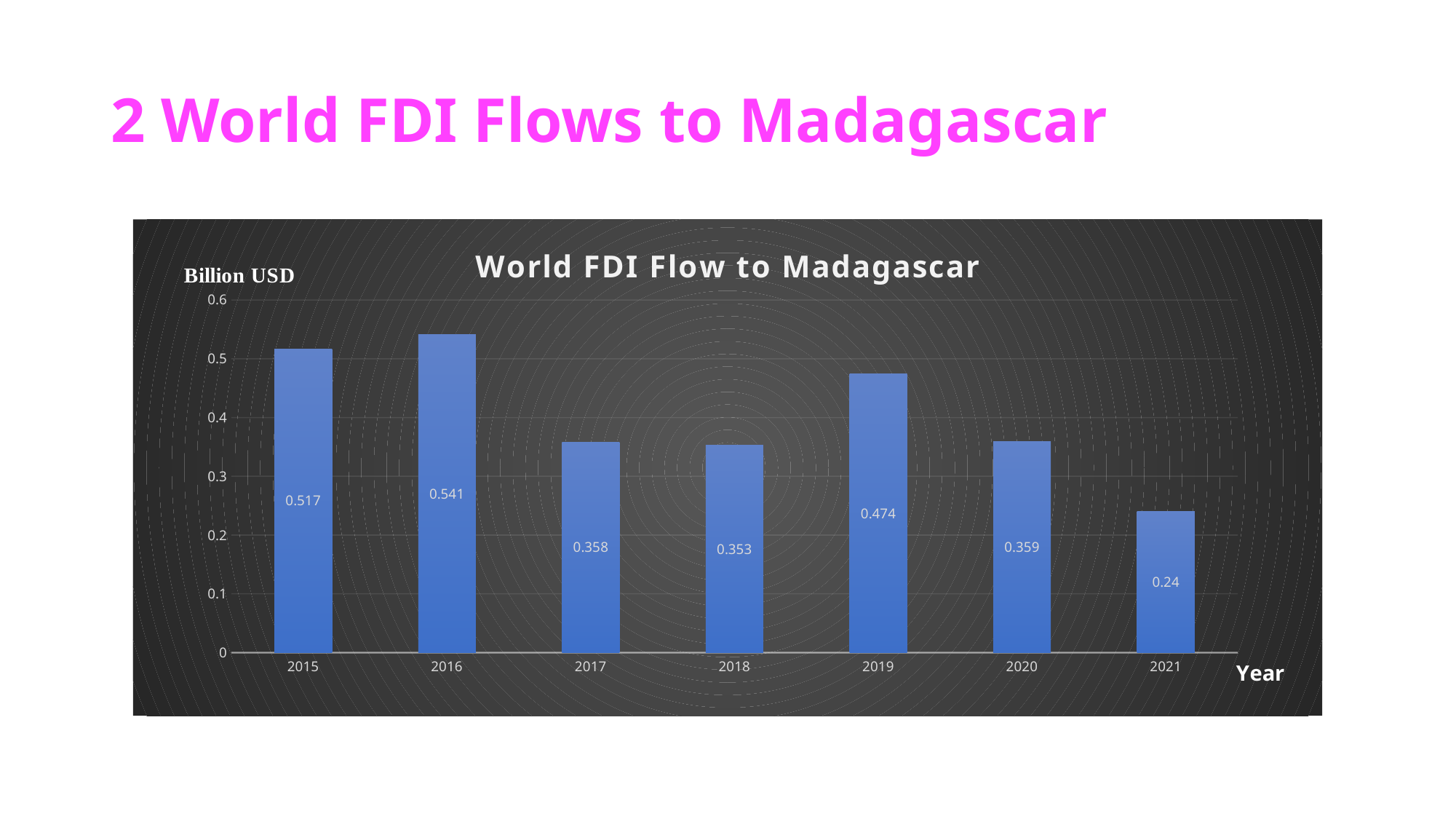
Is the FDI flow for 2018 greater or less than 0.4? less How many years are shown on the chart? 7 Which year has the highest World FDI flow to Madagascar? 2016 What kind of chart is shown on the slide? bar chart What is the World FDI flow to Madagascar in 2021? 0.24 Which year has the lowest World FDI flow to Madagascar? 2021 What is the World FDI flow to Madagascar in 2019? 0.474 Which year has a larger FDI flow, 2015 or 2019? 2015 What is the difference between the FDI flow in 2016 and in 2021? 0.301 What is the World FDI flow to Madagascar in 2016? 0.541 What is the difference between the FDI flow in 2015 and in 2019? 0.043 What unit is shown on the vertical axis of the chart? Billion USD